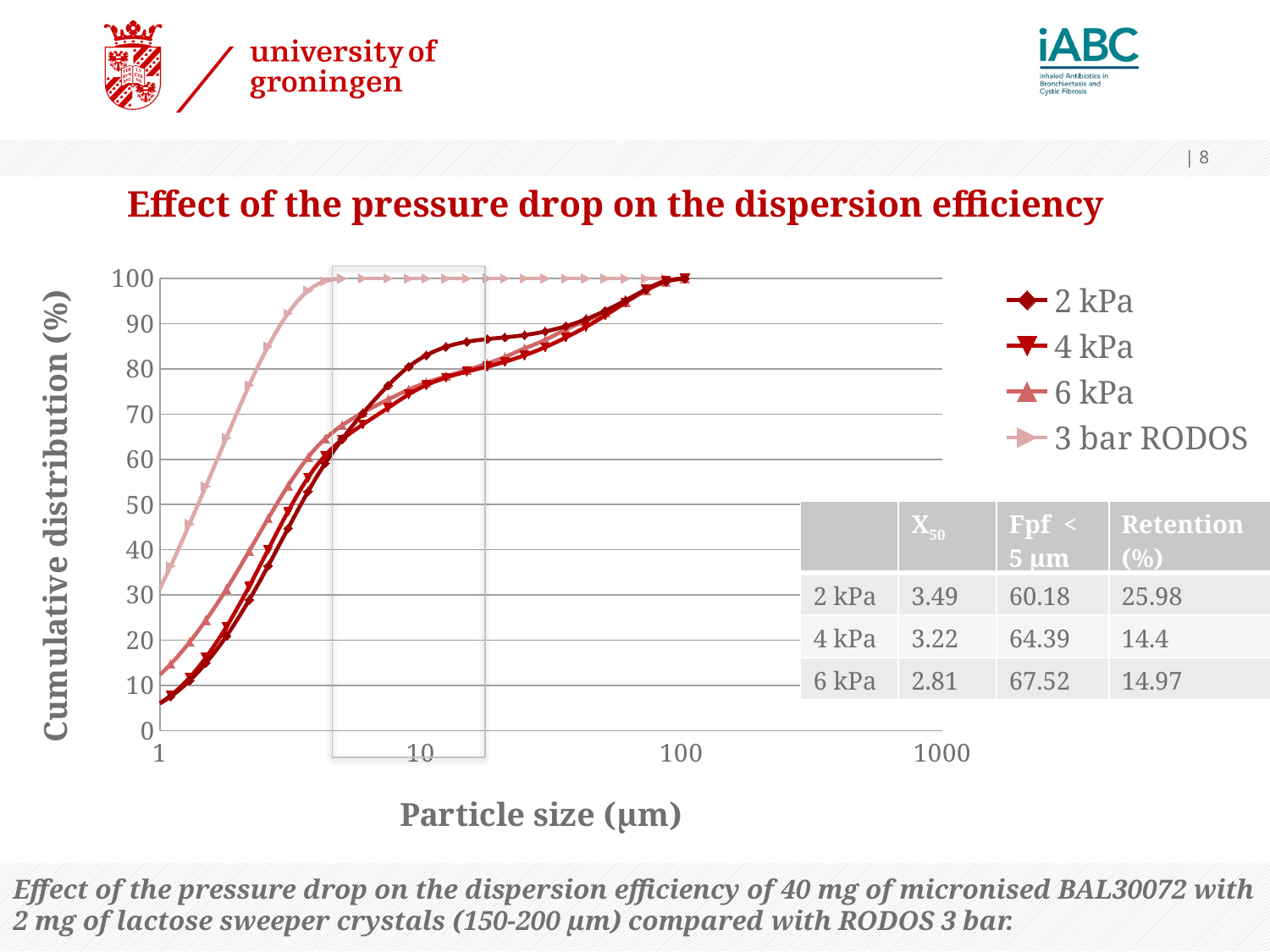
What kind of chart is shown on the slide? line chart What is the label of the chart's y axis? Cumulative distribution (%) Do the cumulative distribution values rise or fall as particle size increases along the x axis? rise At a particle size of 1 µm, which has the larger cumulative distribution, 6 kPa or 2 kPa? 6 kPa Which series has the highest cumulative distribution at a particle size of 1 µm? 3 bar RODOS At a particle size of 10 µm, is the cumulative distribution for 3 bar RODOS greater or less than 90? greater At a particle size of 1 µm, is the cumulative distribution for 2 kPa greater or less than 10? less Which series reaches 100% cumulative distribution at the smallest particle size? 3 bar RODOS At a particle size of 1 µm, is the cumulative distribution for 6 kPa greater or less than 10? greater What is the label of the chart's x axis? Particle size (µm) How many series does the chart legend list? 4 What is the highest value shown on the chart's y axis? 100